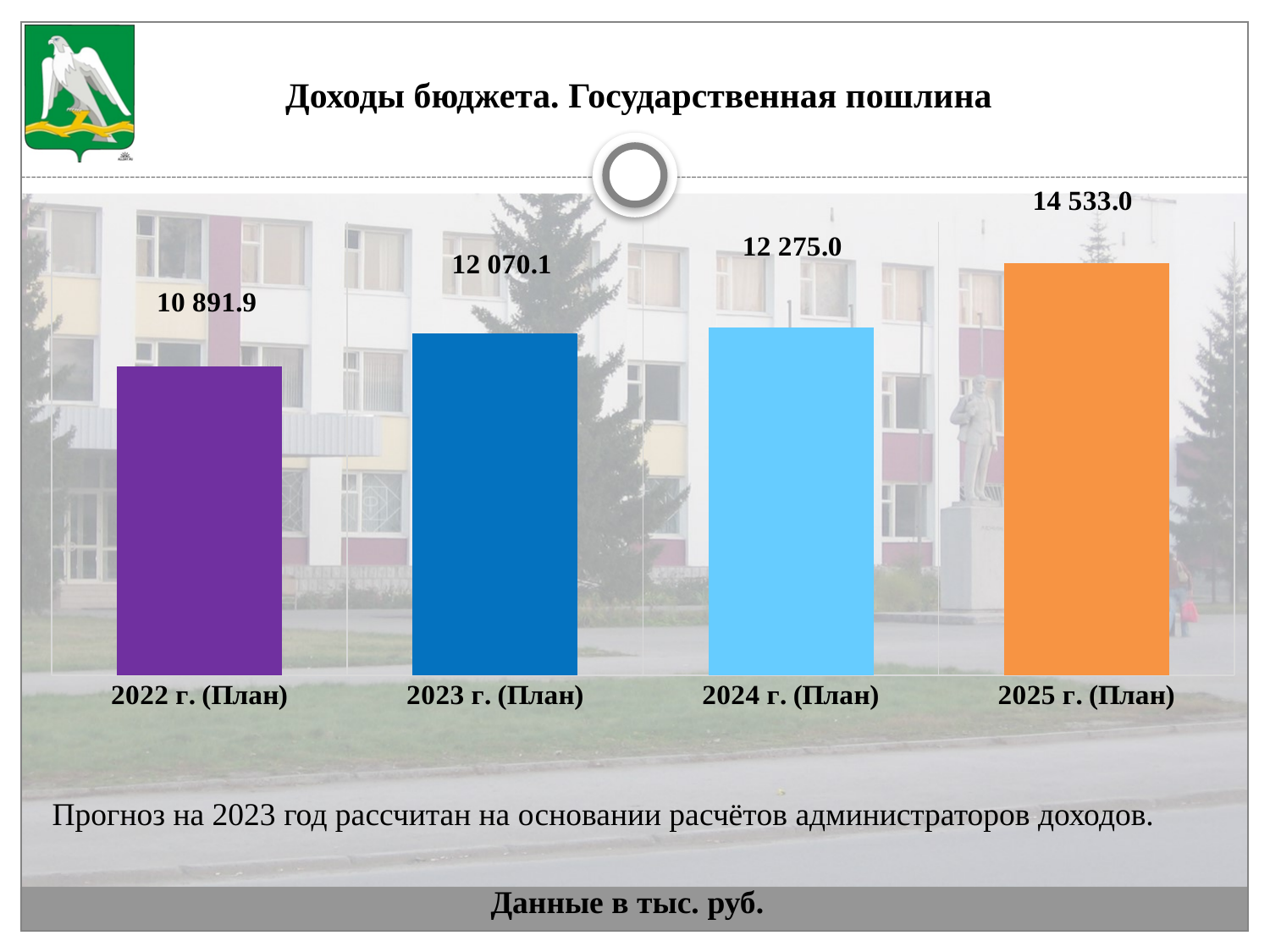
What is the value for 2022 г. (План)? 10 891.9 What kind of chart is shown on the slide? Bar chart Which year has the highest value? 2025 г. (План) How many bars are shown in the chart? 4 What is the value for 2024 г. (План)? 12 275.0 What is the value for 2023 г. (План)? 12 070.1 What is the difference between the values for 2024 г. (План) and 2023 г. (План)? 204.9 Which is larger, the value for 2023 г. (План) or 2024 г. (План)? 2024 г. (План) What is the value for 2025 г. (План)? 14 533.0 Do the values rise or fall from 2022 to 2025? Rise Which year has the lowest value? 2022 г. (План) What is the difference between the values for 2025 г. (План) and 2022 г. (План)? 3 641.1